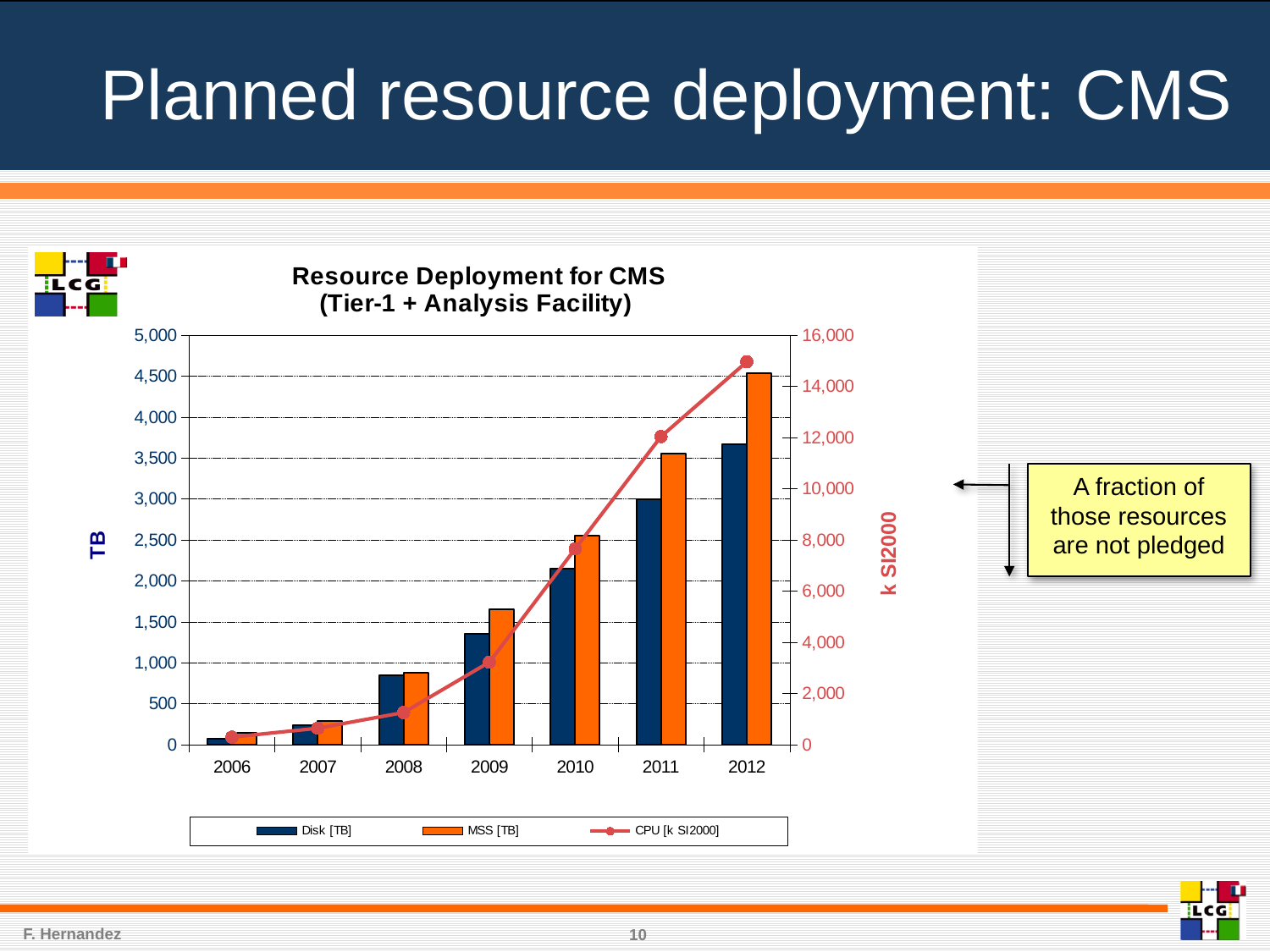
How many years are shown on the x axis? 7 What kind of chart is shown on the slide? Combined bar and line chart Is the CPU [k SI2000] value for 2012 greater or less than 14,000? greater Do the CPU [k SI2000] values rise or fall from 2006 to 2012? rise Which year has the highest MSS [TB] value? 2012 How many series does the legend list? 3 Is the Disk [TB] value for 2008 greater or less than 1,000? less Which is larger in 2011, the Disk [TB] bar or the MSS [TB] bar? MSS [TB] Is the Disk [TB] value for 2012 greater or less than 3,500? greater What is the label of the right-hand vertical axis? k SI2000 Which year has the lowest Disk [TB] value? 2006